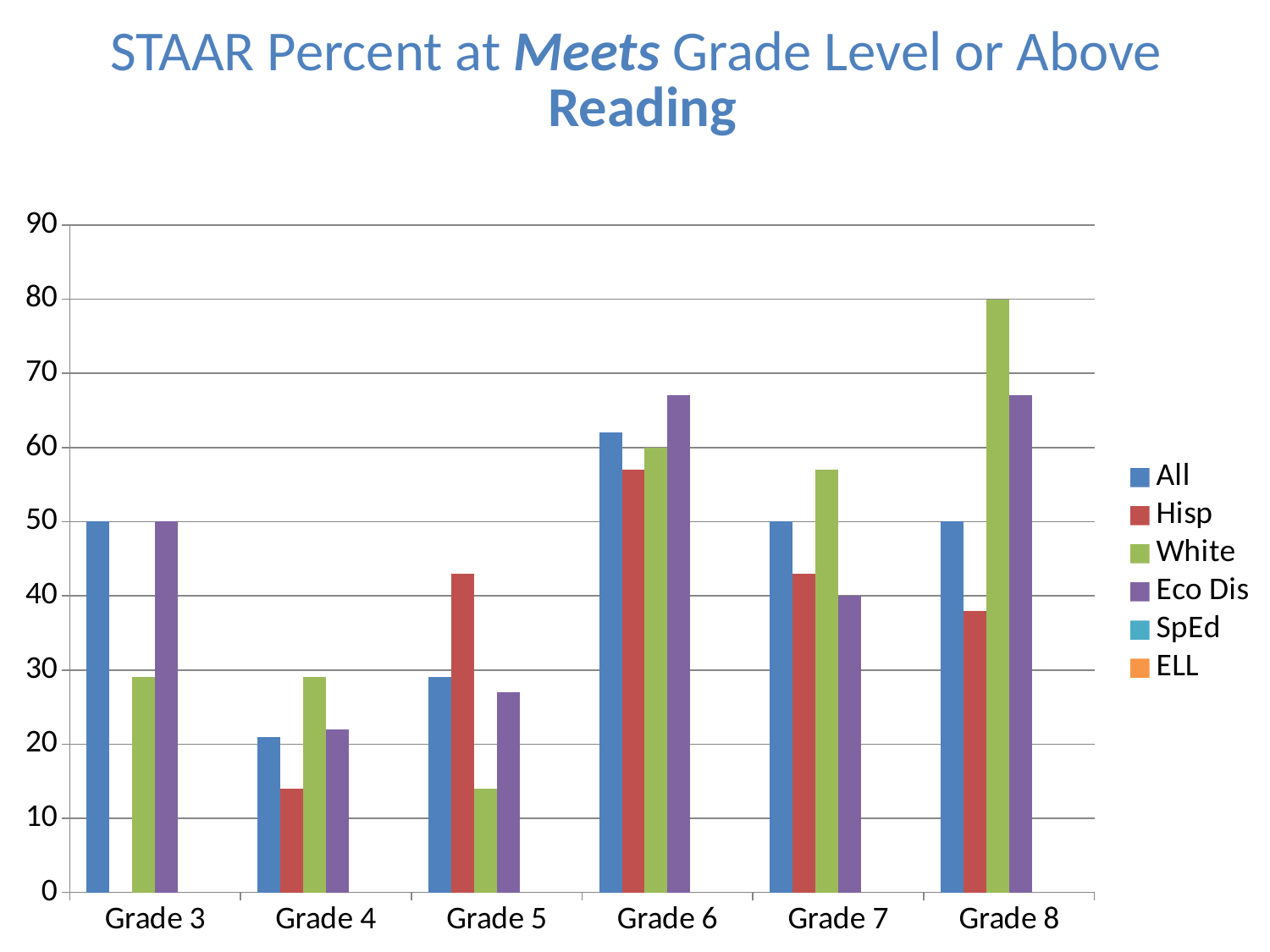
What is the value of the Eco Dis bar for Grade 7? 40 Is the value of the Eco Dis bar for Grade 6 greater or less than 60? greater How many series does the legend list? 6 For Grade 5, which is larger: the Hisp bar or the White bar? Hisp What is the value of the White bar for Grade 8? 80 Which grade has the highest White bar? Grade 8 Which grade has the lowest All bar? Grade 4 What is the difference between the White bar and the All bar for Grade 8? 30 What is the value of the All bar for Grade 3? 50 What kind of chart is shown on the slide? bar chart Is the value of the Hisp bar for Grade 4 greater or less than 20? less How many grade categories are shown on the x axis? 6